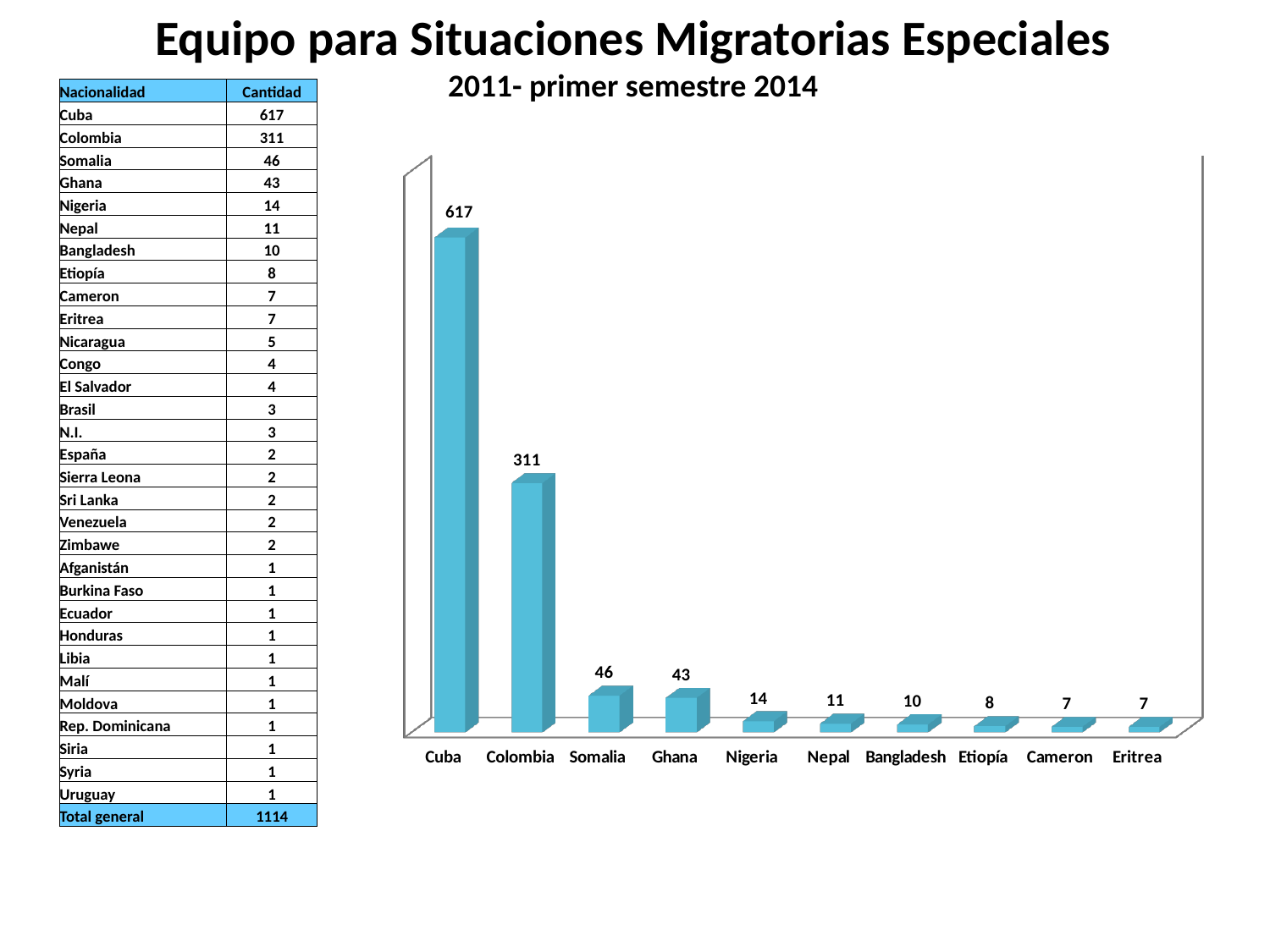
What kind of chart is shown on the slide? Bar chart What is the value for Cuba in the chart? 617 What is the subtitle shown above the chart? 2011- primer semestre 2014 What is the difference between the values for Somalia and Ghana? 3 What is the difference between the values for Cuba and Colombia? 306 What is the value for Bangladesh in the chart? 10 What is the value for Colombia in the chart? 311 Which category has the highest value in the chart? Cuba Which is larger, the value for Nigeria or the value for Nepal? Nigeria What is the value for Ghana in the chart? 43 How many categories are shown on the x axis of the chart? 10 Do the values rise or fall from left to right along the x axis? Fall